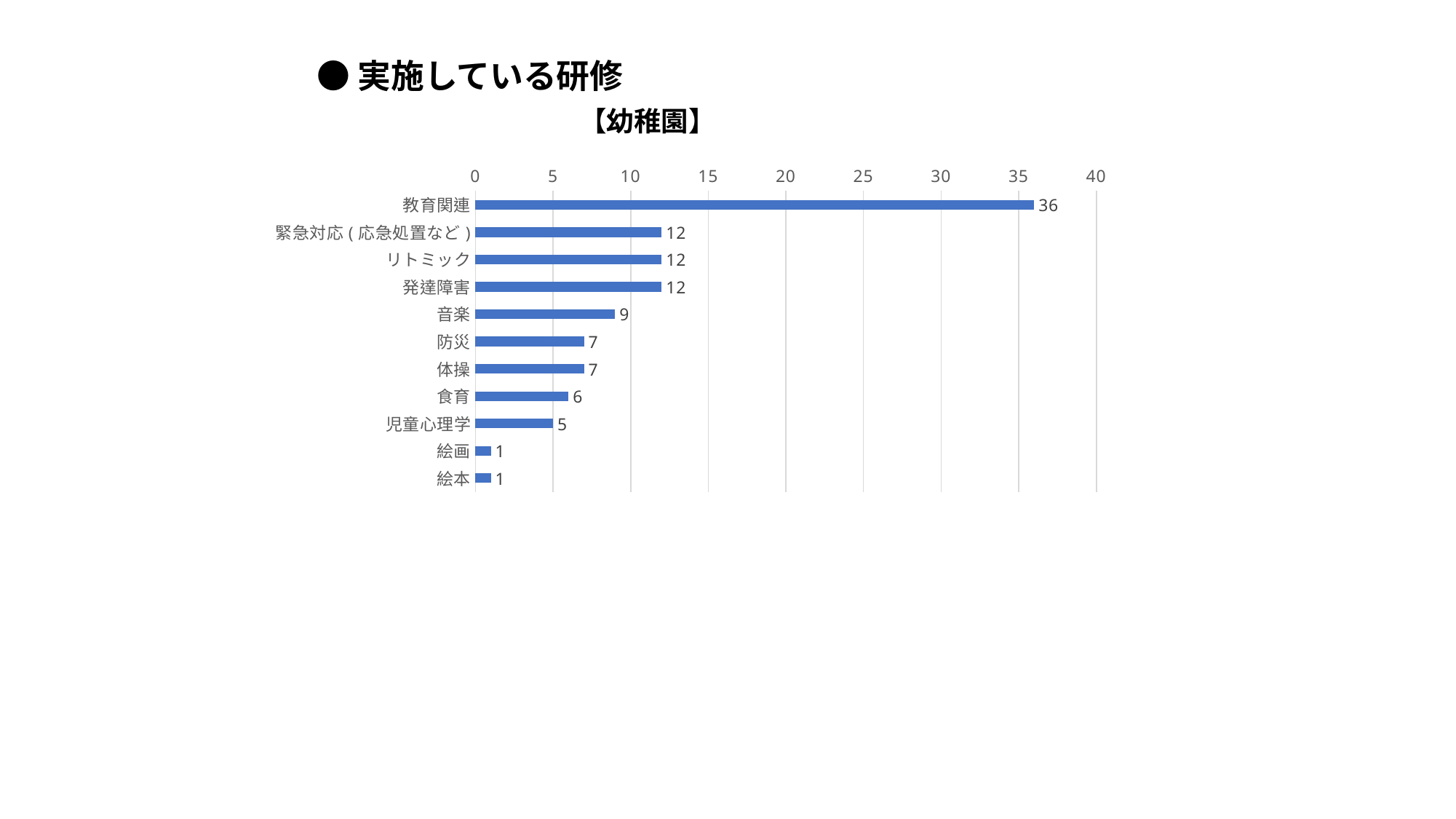
Which is larger, the value for 食育 or the value for 児童心理学? 食育 What is the difference between the values for 教育関連 and 発達障害? 24 What is the value for 音楽? 9 What kind of chart is shown on the slide? bar chart What is the value for 教育関連? 36 Is the value for 教育関連 greater or less than 35? greater What is the value for 食育? 6 What is the value for 児童心理学? 5 What is the difference between the values for 音楽 and 防災? 2 How many categories are shown in the chart? 11 Which category has the highest value? 教育関連 What is the subtitle shown above the chart? 【幼稚園】